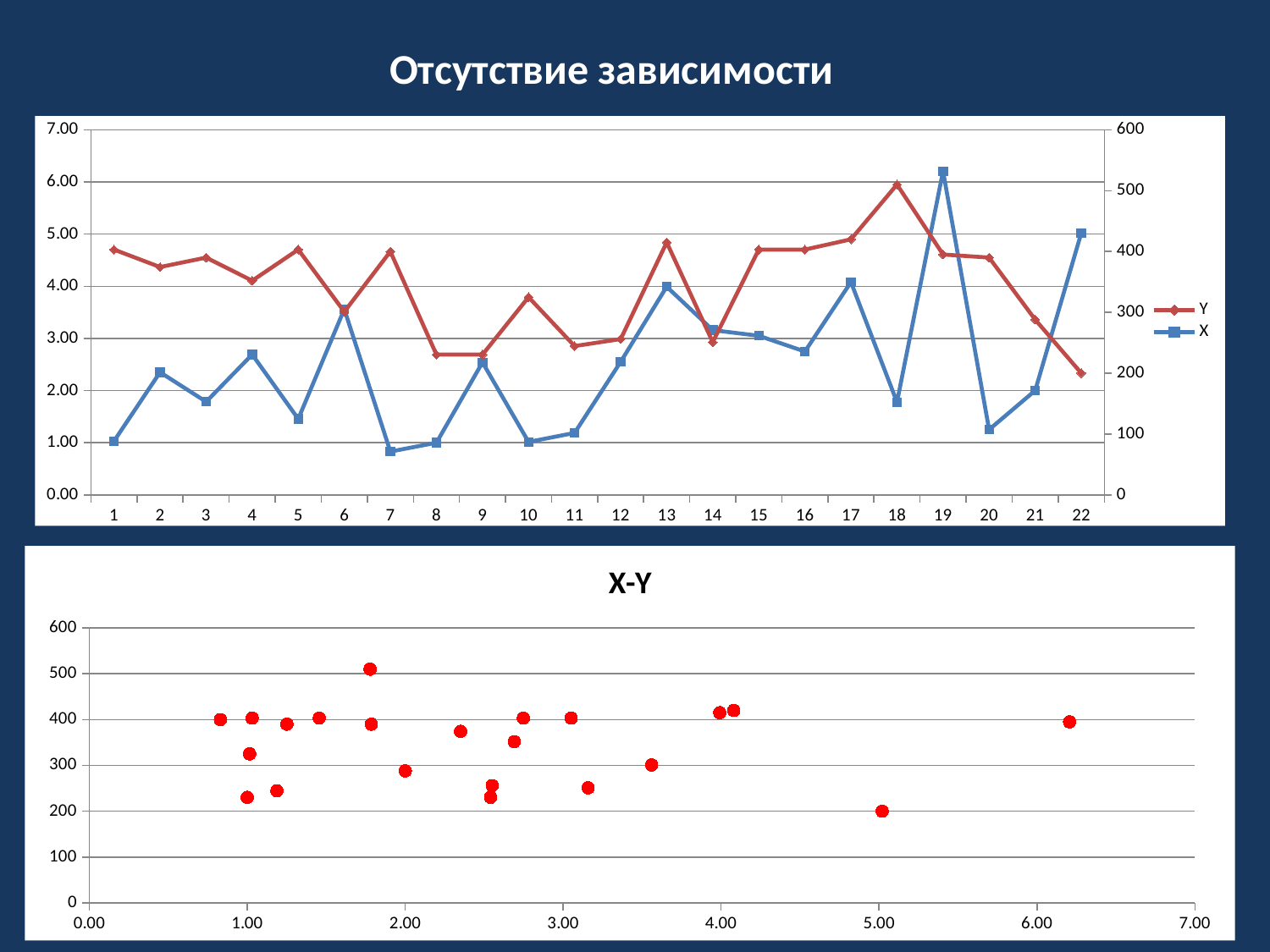
What kind of chart is the bottom chart titled X-Y? scatter chart What is the title of the bottom chart? X-Y In the top chart, at which x-axis point does the Y series reach its highest value? 18 In the top chart, at which x-axis point does the Y series reach its lowest value? 22 In the top chart, at which x-axis point does the X series reach its lowest value? 7 In the top chart, which is larger: the X series value at point 19 or at point 20? point 19 How many points are plotted along the x axis of the top chart? 22 What kind of chart is the top chart on the slide? line chart In the top chart, at which x-axis point does the X series reach its highest value? 19 How many series does the legend of the top chart list? 2